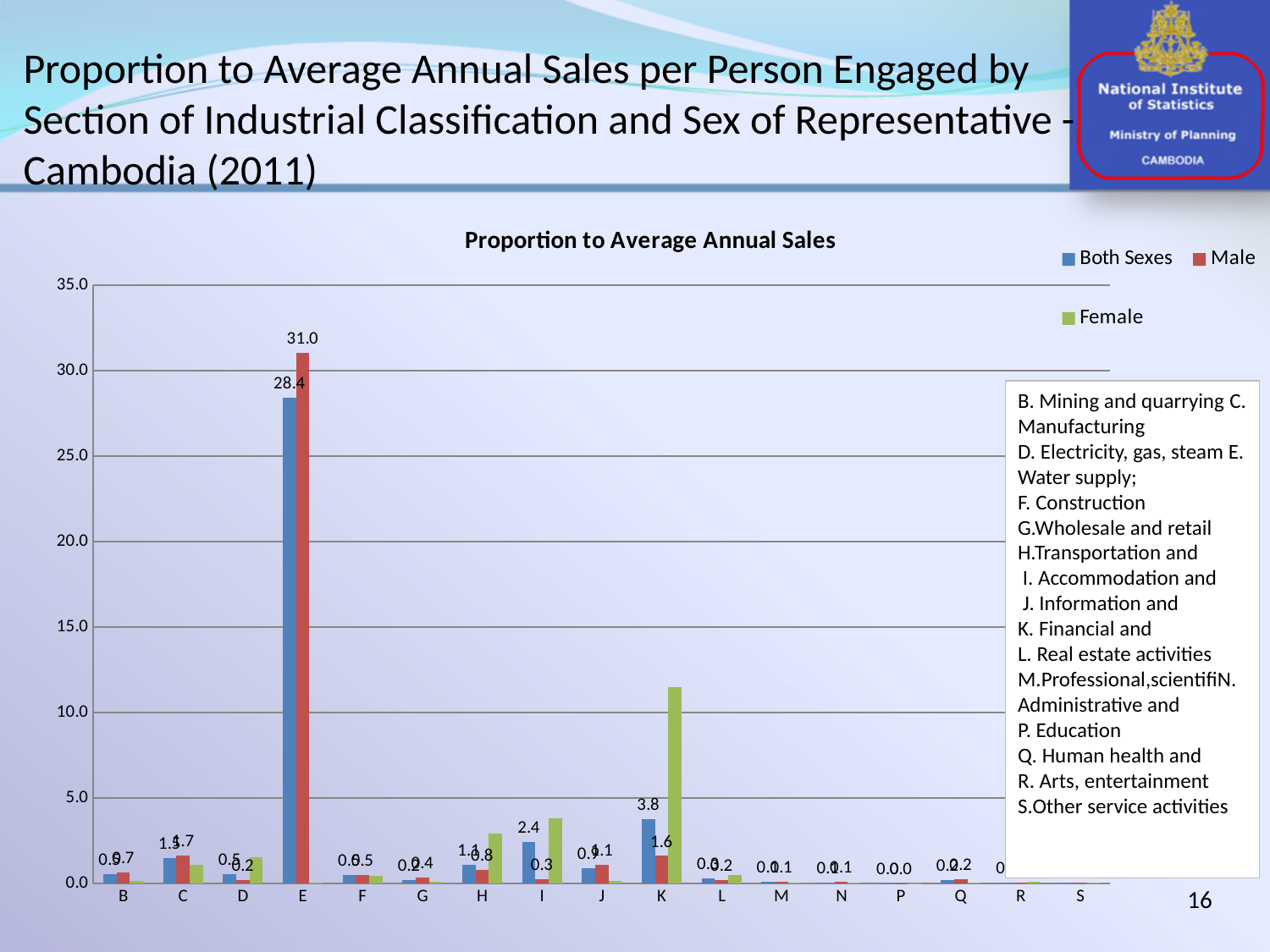
For category K, which is larger: the Both Sexes value or the Male value? Both Sexes What is the title of the chart? Proportion to Average Annual Sales What kind of chart is shown on the slide? bar chart What is the Male value for category E? 31.0 How many series does the legend list? 3 How many categories are shown along the x axis? 17 What is the difference between the Male and Both Sexes values for category E? 2.6 Is the Female value for category K greater or less than 10.0? greater Which category has the highest Male value? E What is the Male value for category I? 0.3 What is the Both Sexes value for category E? 28.4 What is the Both Sexes value for category K? 3.8